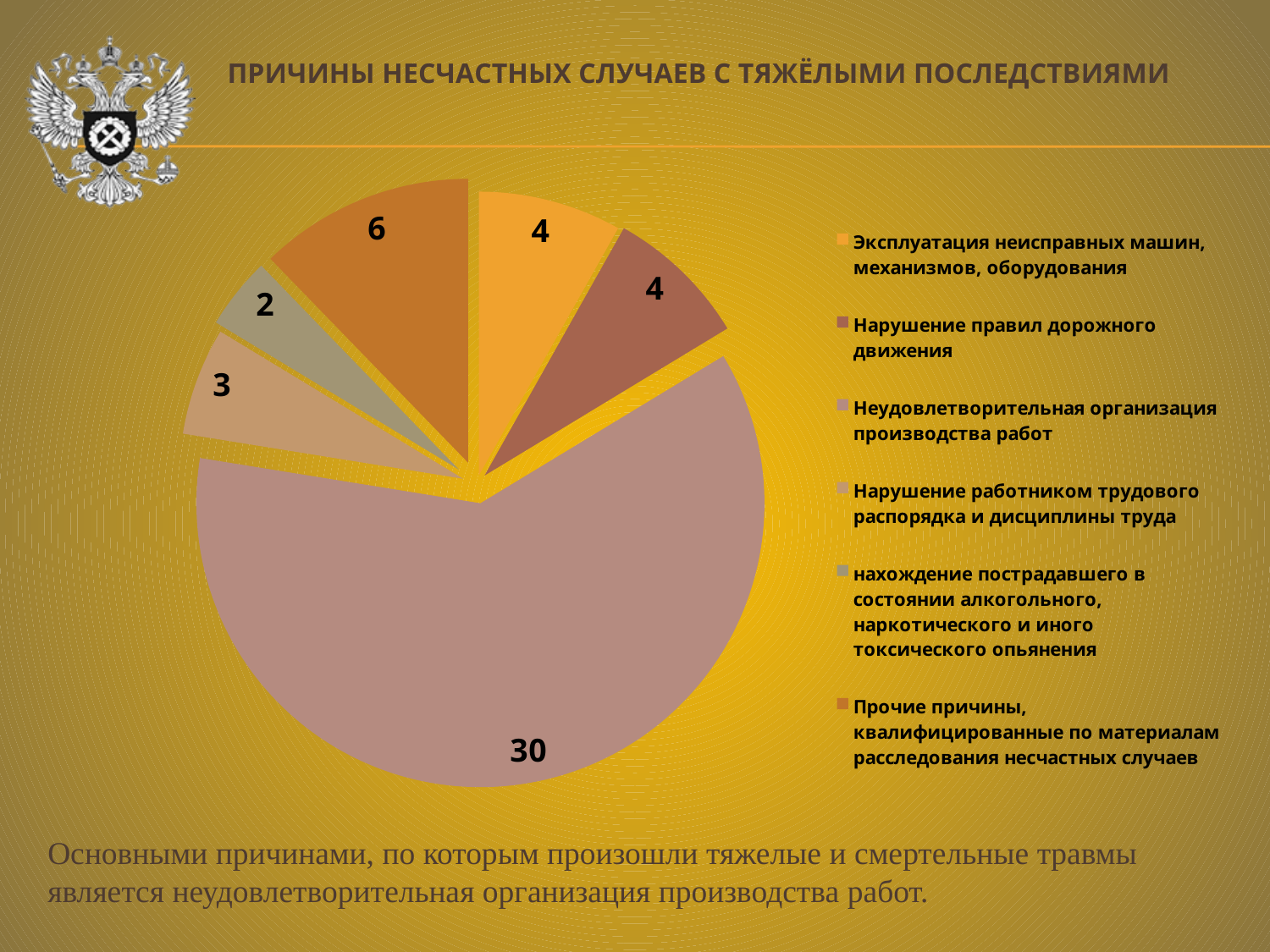
What is the value for "Нарушение работником трудового распорядка и дисциплины труда"? 3 What is the difference between the value for "Неудовлетворительная организация производства работ" and the value for "Прочие причины"? 24 Which is larger: the value for "Прочие причины" or the value for "Нарушение работником трудового распорядка и дисциплины труда"? Прочие причины What is the value for "нахождение пострадавшего в состоянии алкогольного, наркотического и иного токсического опьянения"? 2 How many categories does the pie chart have? 6 What is the value for "Неудовлетворительная организация производства работ"? 30 Which category has the smallest slice of the pie? нахождение пострадавшего в состоянии алкогольного, наркотического и иного токсического опьянения What is the title of the chart on the slide? ПРИЧИНЫ НЕСЧАСТНЫХ СЛУЧАЕВ С ТЯЖЁЛЫМИ ПОСЛЕДСТВИЯМИ What is the value for "Прочие причины, квалифицированные по материалам расследования несчастных случаев"? 6 What kind of chart is shown on the slide? Pie chart Which category has the largest slice of the pie? Неудовлетворительная организация производства работ What is the value for "Нарушение правил дорожного движения"? 4